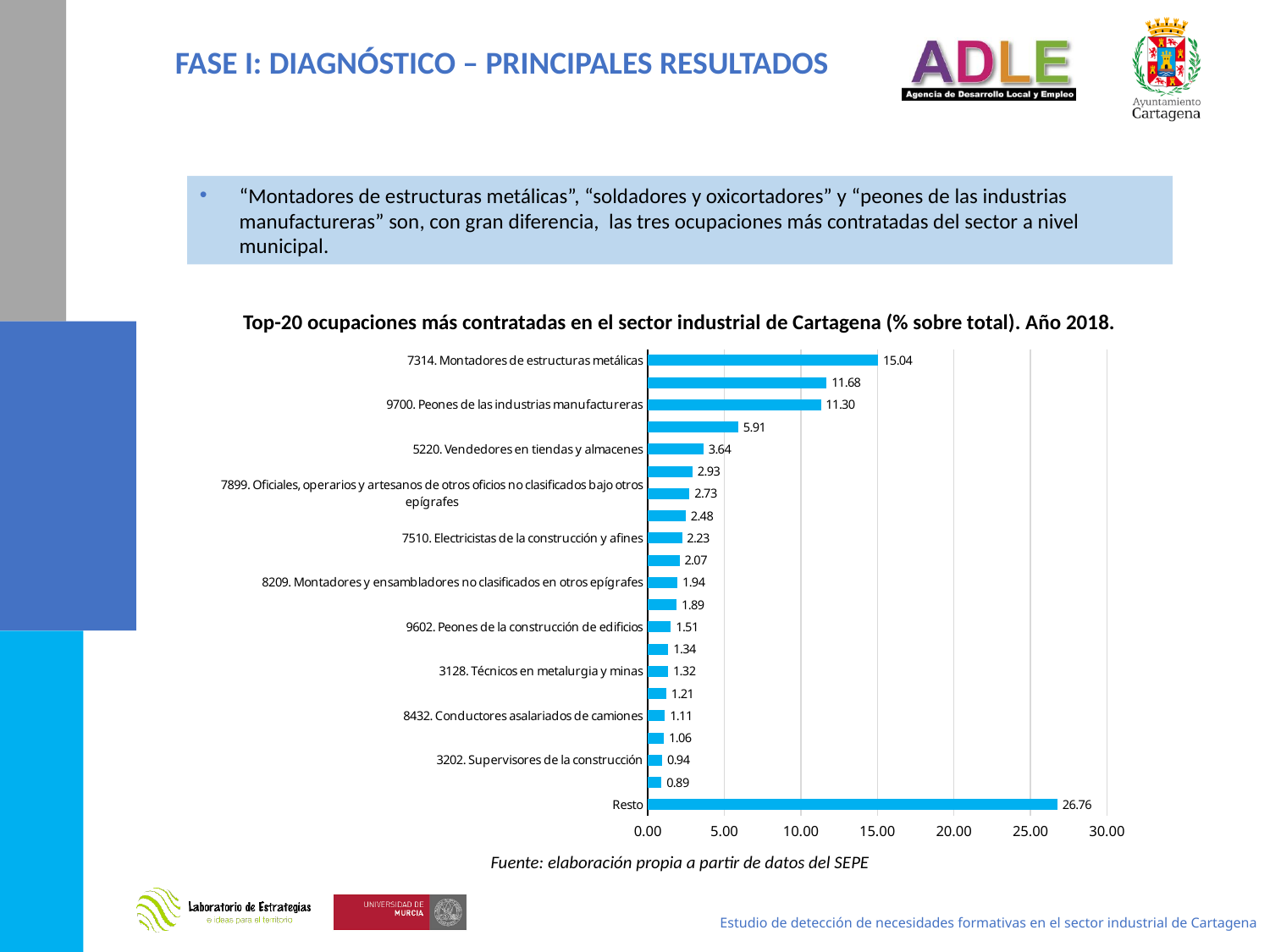
What kind of chart is shown on the slide? Bar chart What is the difference between the values for "7314. Montadores de estructuras metálicas" and "9700. Peones de las industrias manufactureras"? 3.74 What is the value for "3202. Supervisores de la construcción"? 0.94 What is the value for "9700. Peones de las industrias manufactureras"? 11.30 What is the title of the chart? Top-20 ocupaciones más contratadas en el sector industrial de Cartagena (% sobre total). Año 2018. Which is larger, the value for "7510. Electricistas de la construcción y afines" or the value for "8432. Conductores asalariados de camiones"? 7510. Electricistas de la construcción y afines How many bars are plotted in the chart? 21 What is the smallest value shown on the chart? 0.89 Which category has the longest bar in the chart? Resto What is the value for "5220. Vendedores en tiendas y almacenes"? 3.64 What is the value for "7314. Montadores de estructuras metálicas"? 15.04 What is the value for "Resto"? 26.76